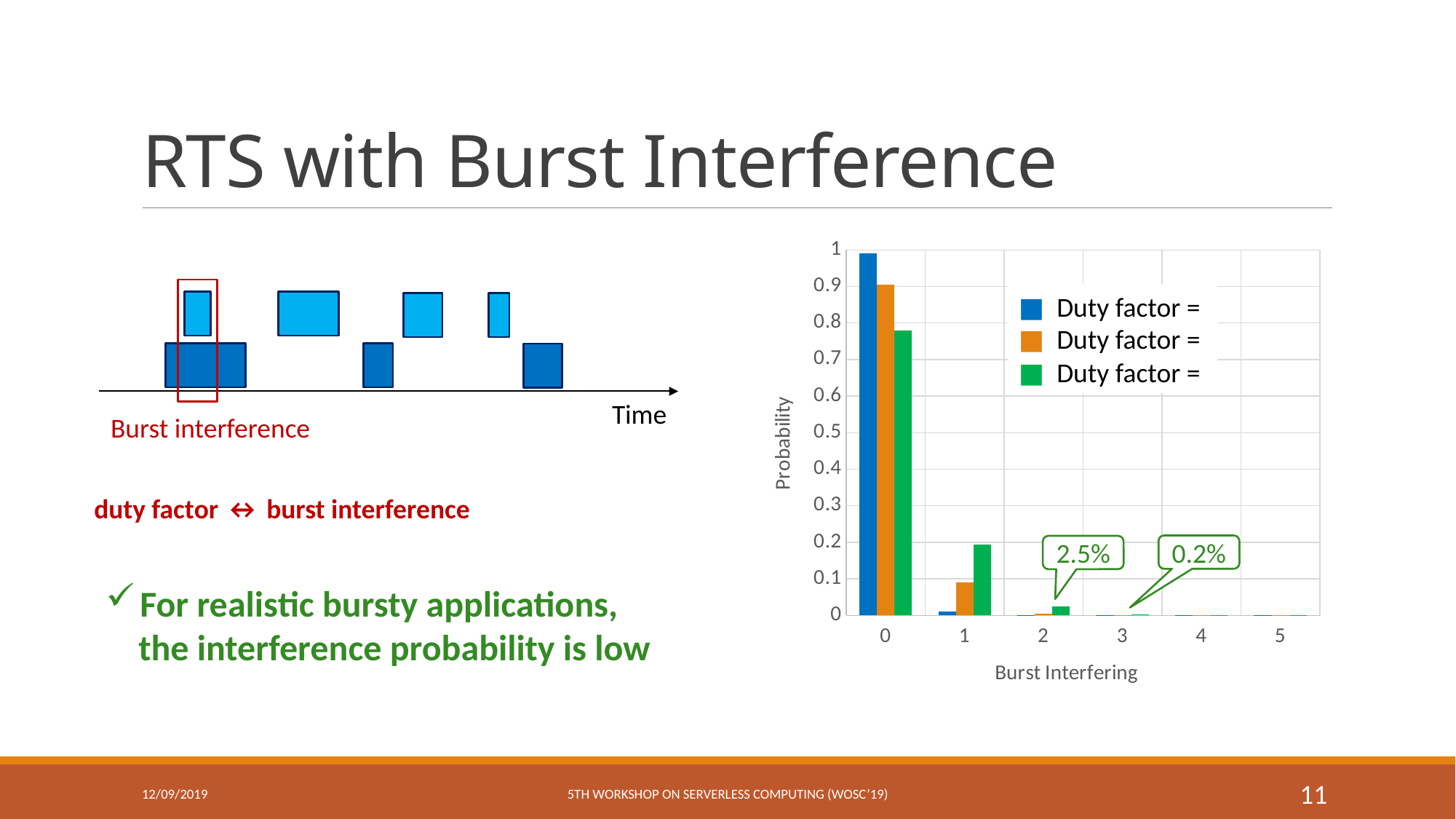
What is the title of the x axis of the chart? Burst Interfering Is the value of the green series at Burst Interfering = 0 greater or less than 0.7? greater What is the labelled probability for the green series at Burst Interfering = 2? 2.5% What kind of chart is shown on the right of the slide? bar chart How many series does the legend of the chart list? 3 Is the value of the blue series at Burst Interfering = 0 greater or less than 0.9? greater What is the difference between the green series' labelled values at Burst Interfering = 2 and Burst Interfering = 3? 2.3% How many categories are shown on the x axis of the chart? 6 Is the value of the green series at Burst Interfering = 1 greater or less than 0.1? greater What is the labelled probability for the green series at Burst Interfering = 3? 0.2% Which series has the highest probability at Burst Interfering = 0? the blue series At Burst Interfering = 1, which is larger: the green series or the orange series? the green series